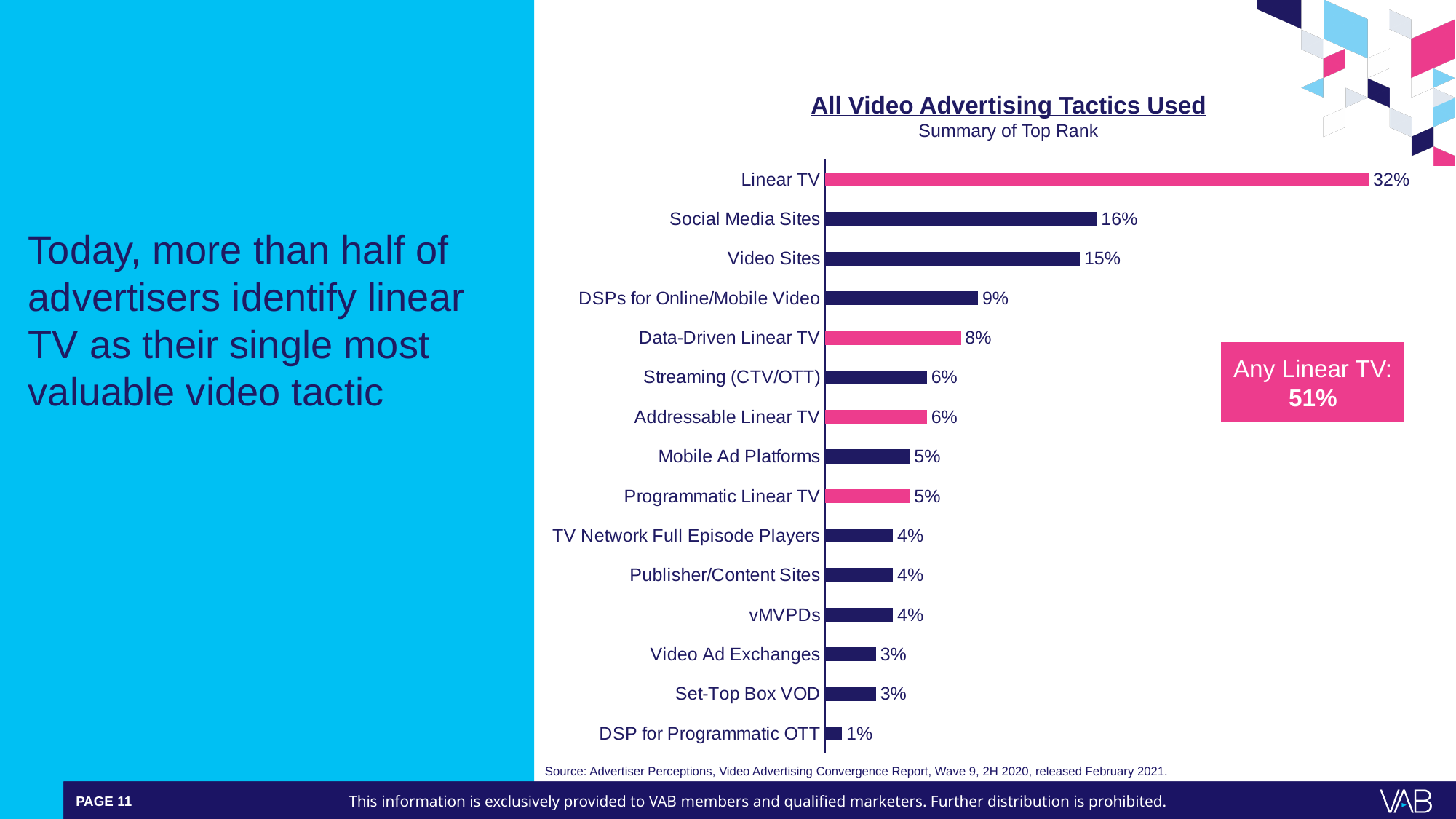
What is the difference between the values for Linear TV and Social Media Sites? 16% Which category has the highest value? Linear TV What kind of chart is shown on the slide? Bar chart What is the value for Set-Top Box VOD? 3% How many categories are shown in the chart? 15 What is the value for Social Media Sites? 16% Which category has the lowest value? DSP for Programmatic OTT Which is larger, the value for Data-Driven Linear TV or the value for Streaming (CTV/OTT)? Data-Driven Linear TV What is the difference between the values for Video Sites and Data-Driven Linear TV? 7% What is the title of the chart? All Video Advertising Tactics Used What is the value for DSPs for Online/Mobile Video? 9% What is the value for Linear TV? 32%